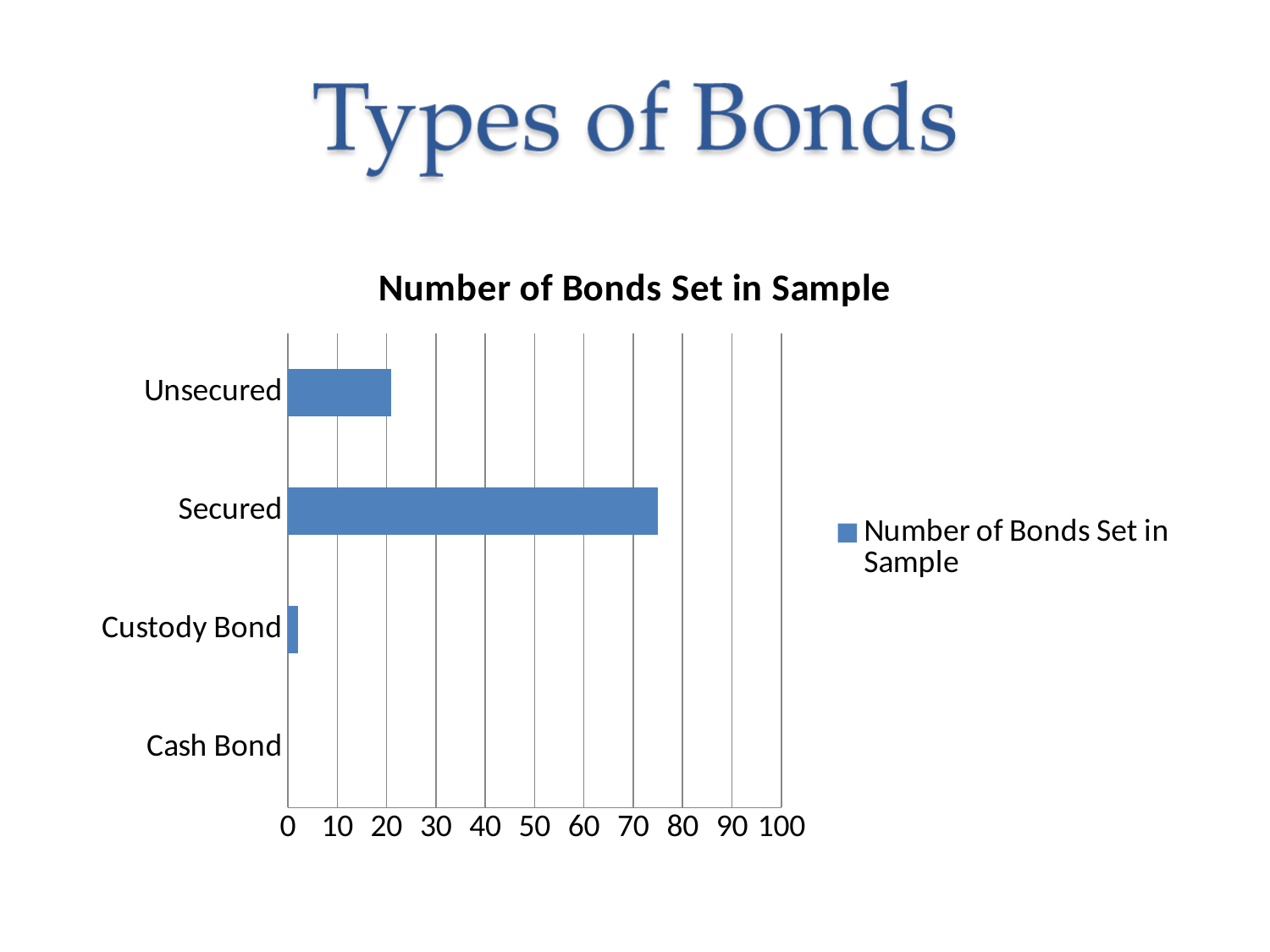
What kind of chart is shown on the slide? bar chart Which has more bonds set in the sample, Unsecured or Custody Bond? Unsecured How many series does the legend list? 1 Is the value for Secured greater or less than 70? greater Is the value for Custody Bond greater or less than 10? less Which has more bonds set in the sample, Unsecured or Secured? Secured Which bond type has the highest number of bonds set in the sample? Secured What is the title of the chart? Number of Bonds Set in Sample Is the value for Unsecured greater or less than 30? less What is the highest value shown on the horizontal axis of the chart? 100 How many bond categories are shown on the chart? 4 Which bond type has the lowest number of bonds set in the sample? Cash Bond